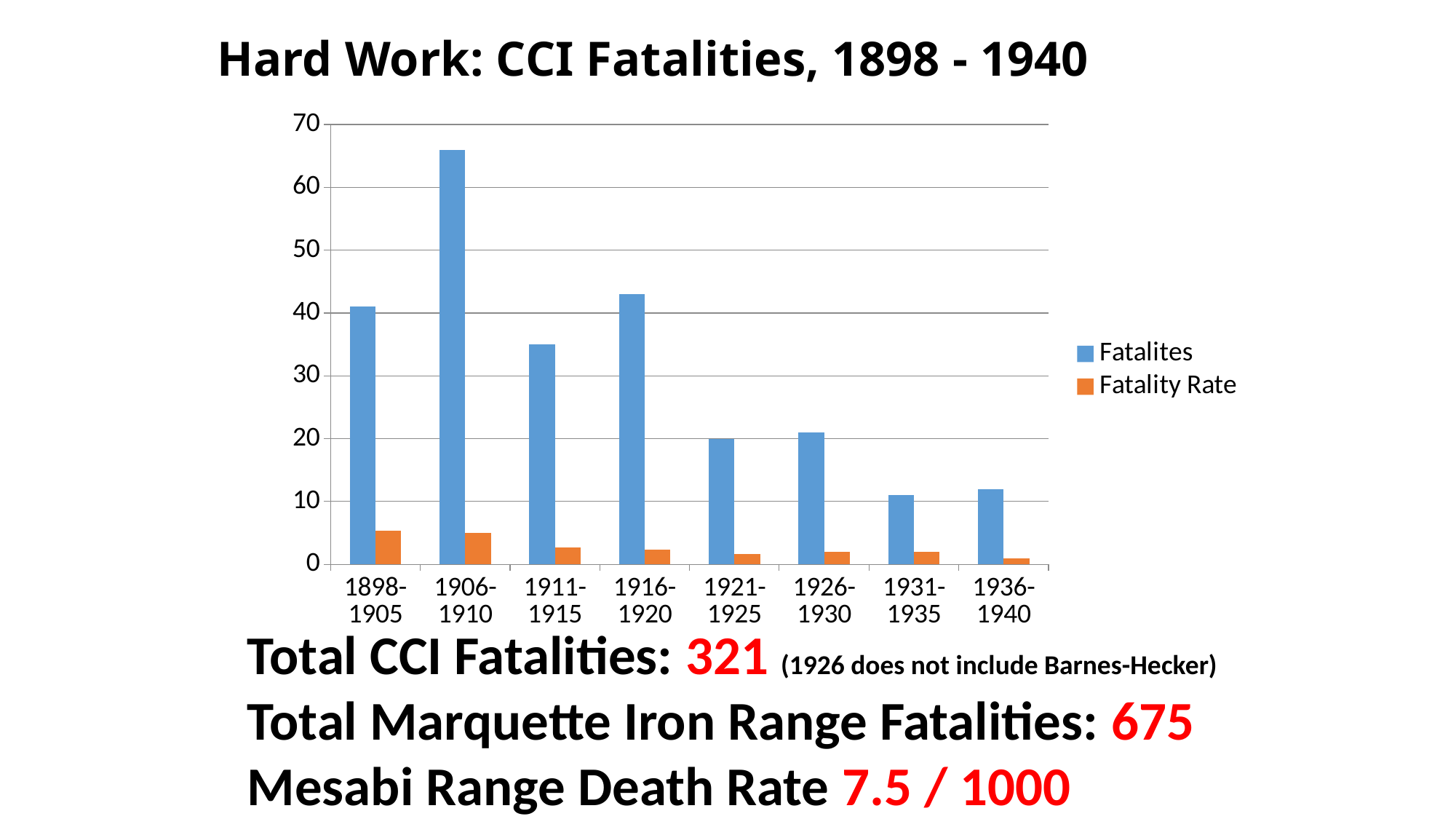
Which period has the lowest Fatality Rate? 1936-1940 Which period has more Fatalites, 1911-1915 or 1916-1920? 1916-1920 How many time periods are shown on the x axis? 8 Is the Fatalites value for 1911-1915 greater or less than 40? less Is the Fatalites value for 1906-1910 greater or less than 60? greater Is the Fatalites value for 1898-1905 greater or less than 30? greater What kind of chart is shown on the slide? bar chart Which period has the highest number of Fatalites? 1906-1910 How many series does the legend list? 2 What is the title of the chart? Hard Work: CCI Fatalities, 1898 - 1940 Do the Fatalites values generally rise or fall from 1916-1920 to 1936-1940? fall